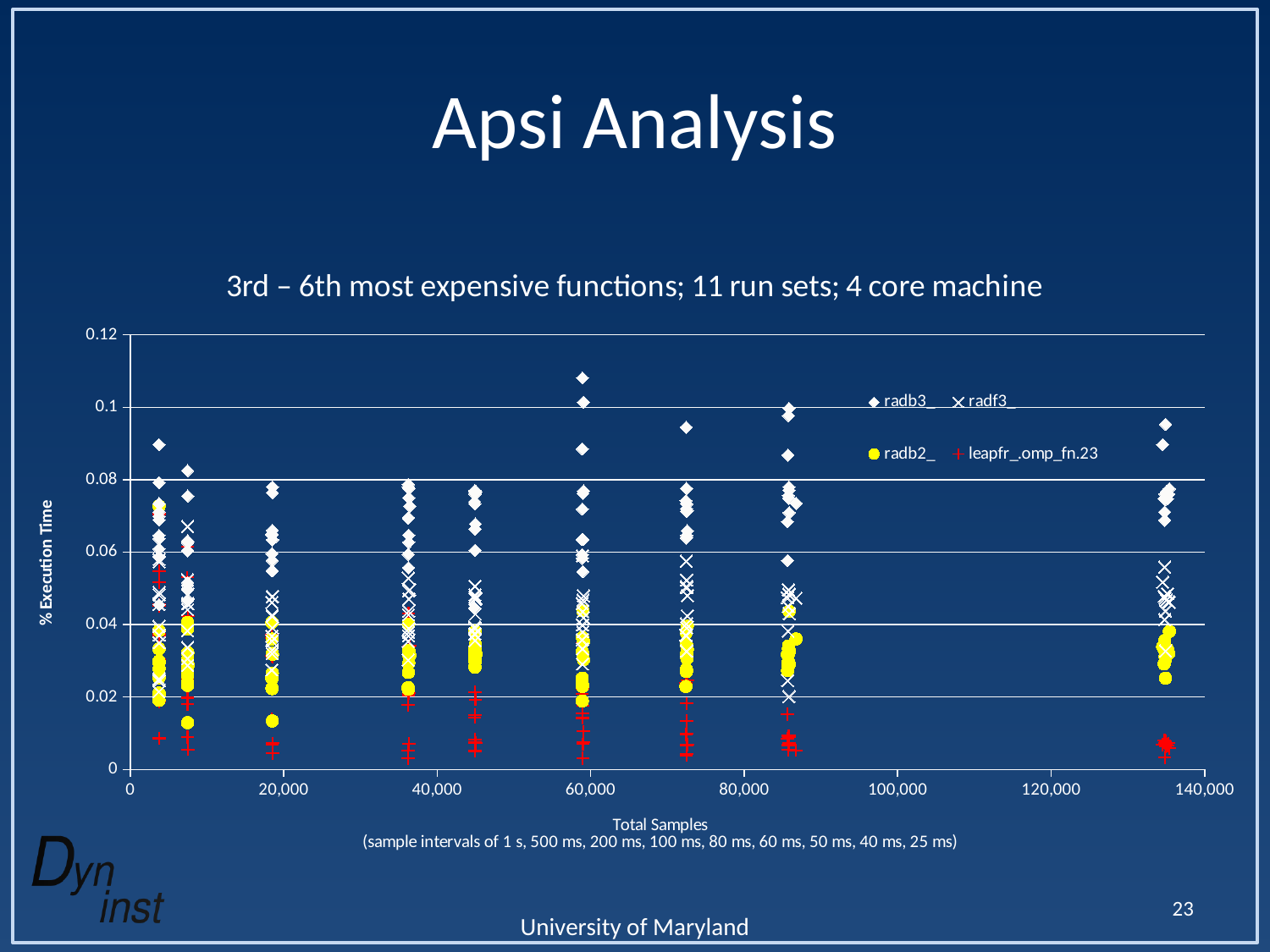
Which series has the highest plotted value on the chart? radb3_ What is the title of the y axis? % Execution Time What kind of chart is shown on the slide? scatter chart Is the highest value for leapfr_.omp_fn.23 greater or less than 0.06? greater Which series has the lowest plotted value on the chart? leapfr_.omp_fn.23 Is the highest value for radf3_ greater or less than 0.08? less How many series does the chart legend list? 4 Is the highest value for radb2_ greater or less than 0.08? less What is the maximum value shown on the y axis? 0.12 Are the radb3_ values generally higher or lower than the leapfr_.omp_fn.23 values? higher